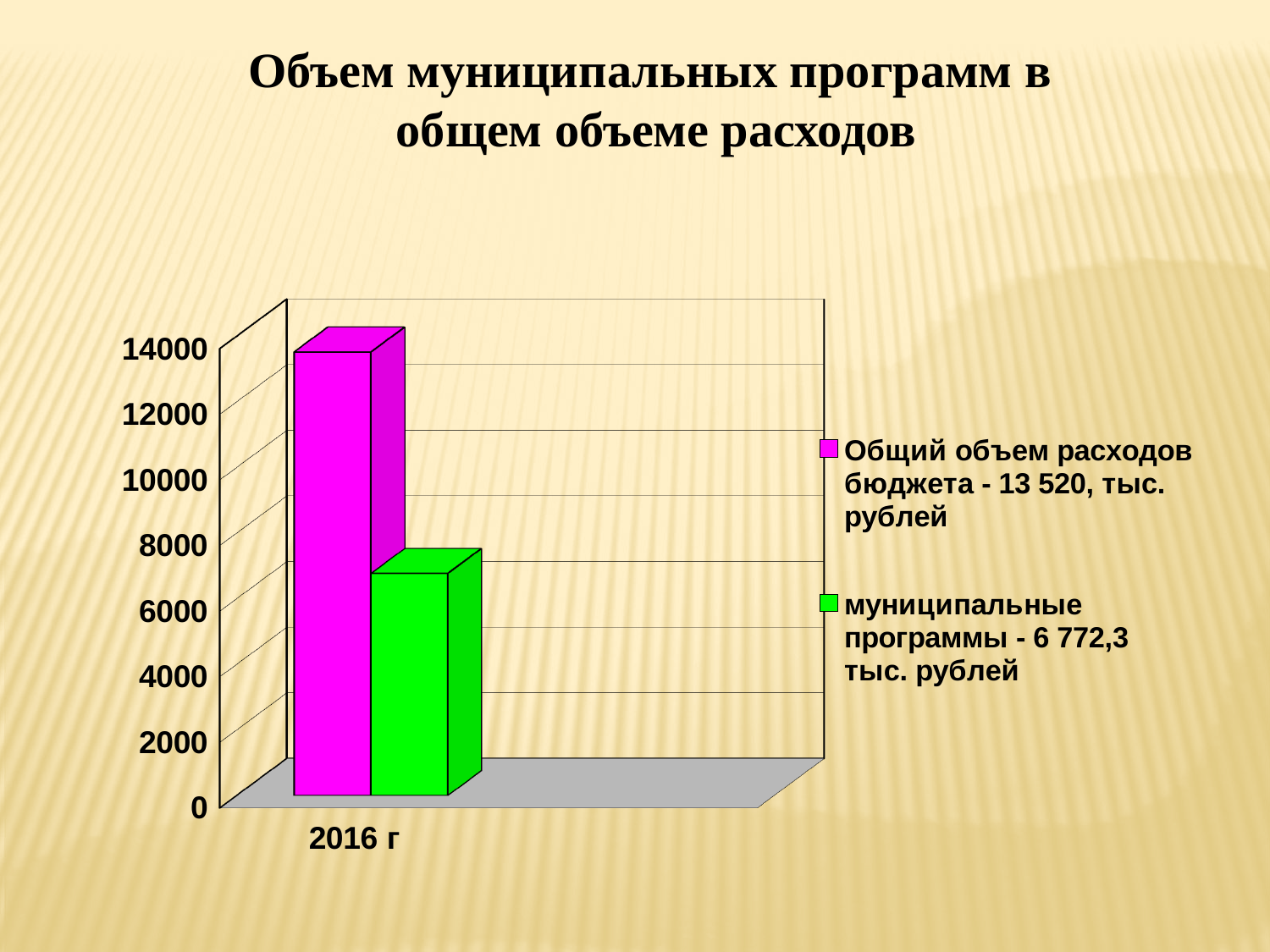
Which year is shown on the x axis? 2016 г Which series has the higher bar: Общий объем расходов бюджета or муниципальные программы? Общий объем расходов бюджета What is the value of the total budget expenditure (Общий объем расходов бюджета) according to the legend? 13 520 тыс. рублей Which series has the lowest value? муниципальные программы What is the difference between the total budget expenditure and the municipal programmes value? 6 747,7 тыс. рублей Is the value for муниципальные программы greater or less than 8000? less How many categories are shown on the x axis? 1 What is the value of municipal programmes (муниципальные программы) according to the legend? 6 772,3 тыс. рублей What type of chart is shown on the slide? Bar chart How many series does the legend list? 2 What is the title of the chart on the slide? Объем муниципальных программ в общем объеме расходов What colour is the bar for Общий объем расходов бюджета? Magenta